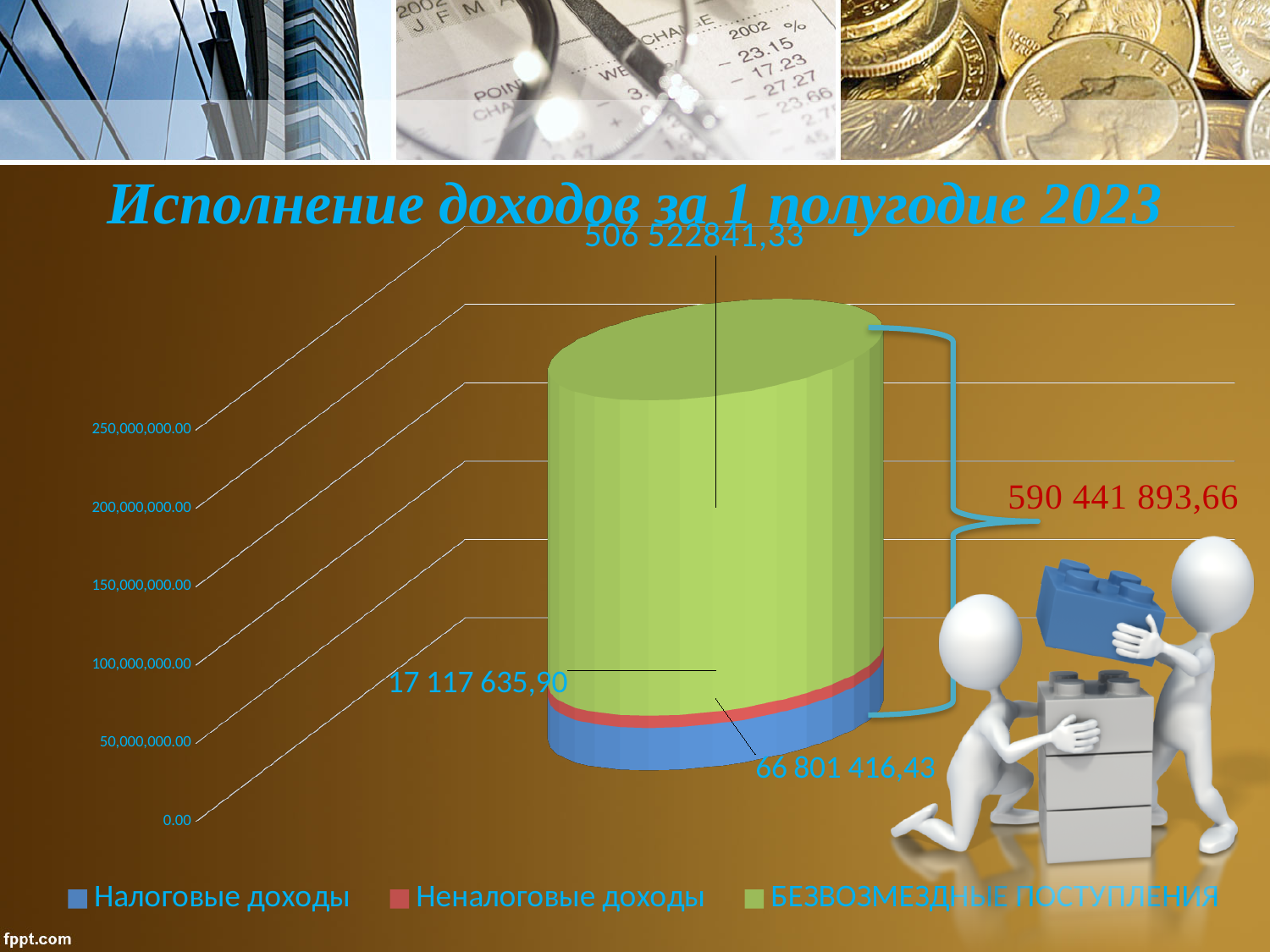
Which series has the highest value? БЕЗВОЗМЕЗДНЫЕ ПОСТУПЛЕНИЯ What is the title of the slide? Исполнение доходов за 1 полугодие 2023 What is the value for Неналоговые доходы? 17 117 635,90 What kind of chart is shown on the slide? Stacked bar chart What is the total of the stacked bar? 590 441 893,66 Which is larger, Налоговые доходы or Неналоговые доходы? Налоговые доходы What is the value for Налоговые доходы? 66 801 416,43 What colour represents Неналоговые доходы in the legend? Red What is the difference between Налоговые доходы and Неналоговые доходы? 49 683 780,53 What is the value for БЕЗВОЗМЕЗДНЫЕ ПОСТУПЛЕНИЯ? 506 522841,33 How many series does the legend list? 3 Which series has the lowest value? Неналоговые доходы